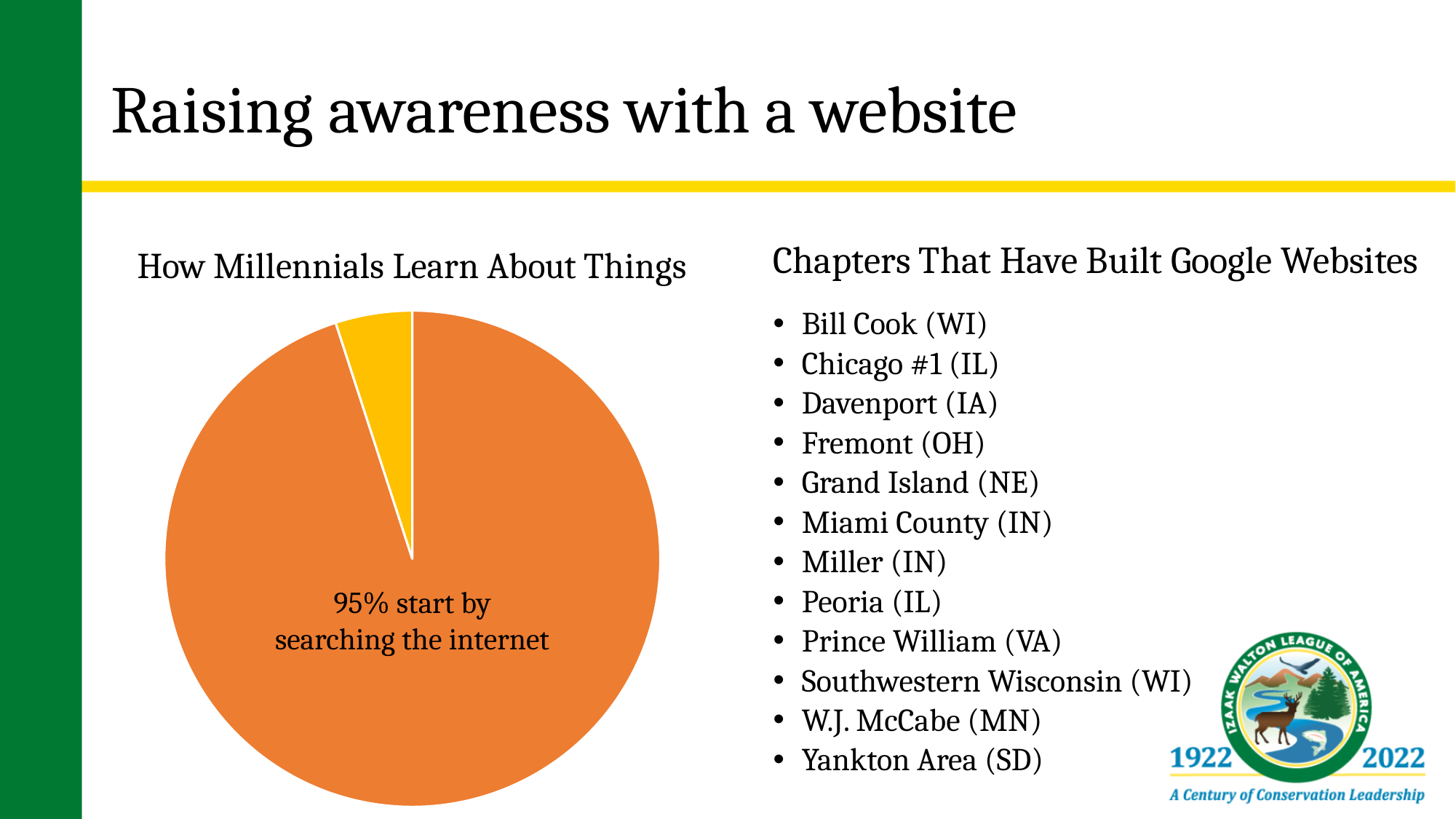
How many slices does the pie chart have? 2 What kind of chart is shown on the slide? pie chart Which slice of the pie chart is the smallest? the yellow slice What colour is the slice labelled "95% start by searching the internet"? orange Which slice of the pie chart is larger, the orange slice or the yellow slice? the orange slice According to the pie chart, what percentage of millennials start by searching the internet? 95% Is the share of millennials who start by searching the internet greater or less than 50%? greater What is the title of the pie chart? How Millennials Learn About Things